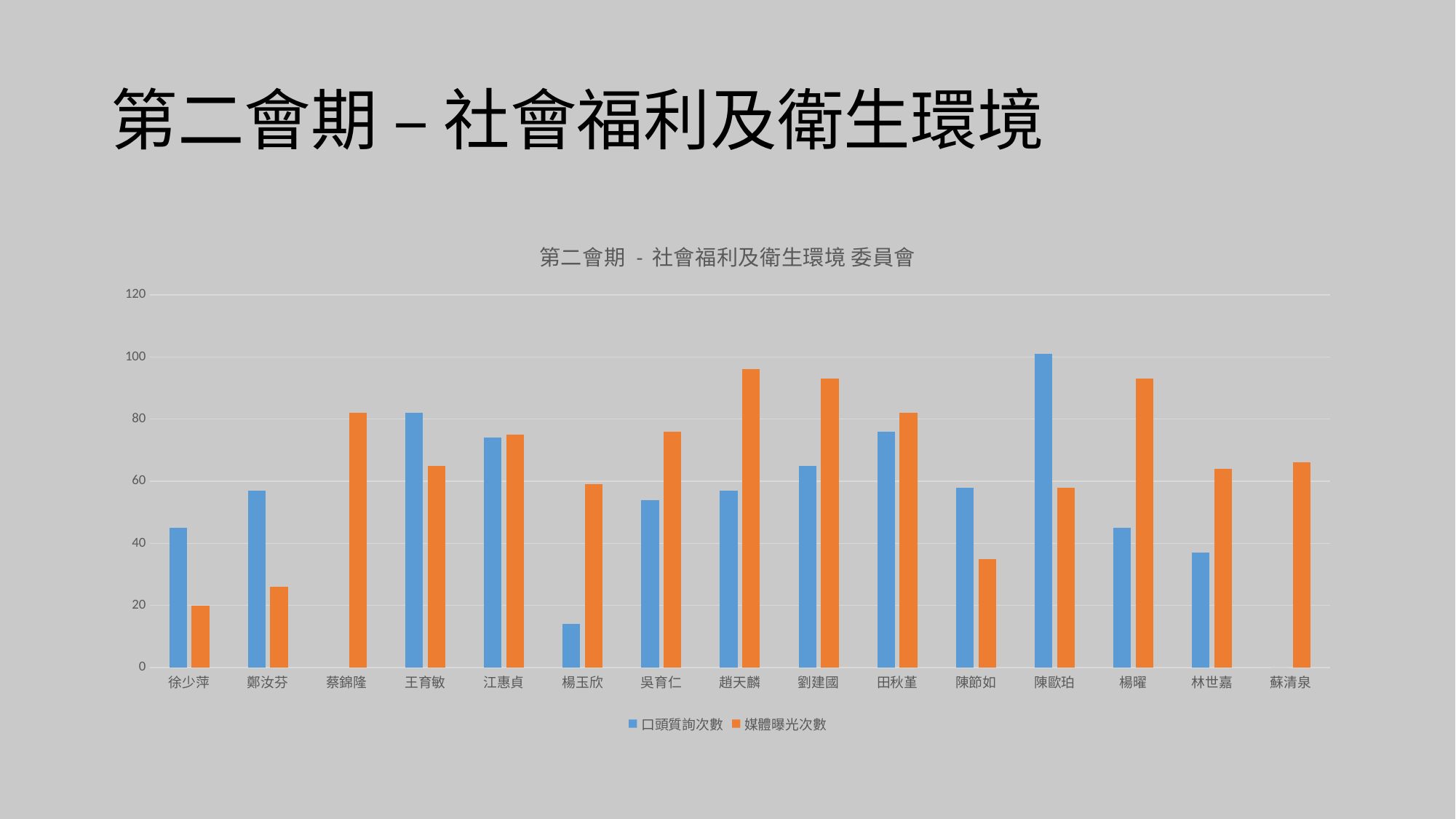
Which legislator has the lowest 媒體曝光次數? 徐少萍 Is the 口頭質詢次數 value for 陳歐珀 greater or less than 80? greater What kind of chart is shown on the slide? bar chart Which legislator has the highest 口頭質詢次數? 陳歐珀 What is the title of the chart? 第二會期 - 社會福利及衛生環境 委員會 Is the 口頭質詢次數 value for 楊玉欣 greater or less than 20? less Is the 媒體曝光次數 value for 蔡錦隆 greater or less than 60? greater For 陳節如, which is larger: 口頭質詢次數 or 媒體曝光次數? 口頭質詢次數 How many series does the legend list? 2 How many legislators (categories) are shown on the x axis? 15 For 楊曜, which is larger: 口頭質詢次數 or 媒體曝光次數? 媒體曝光次數